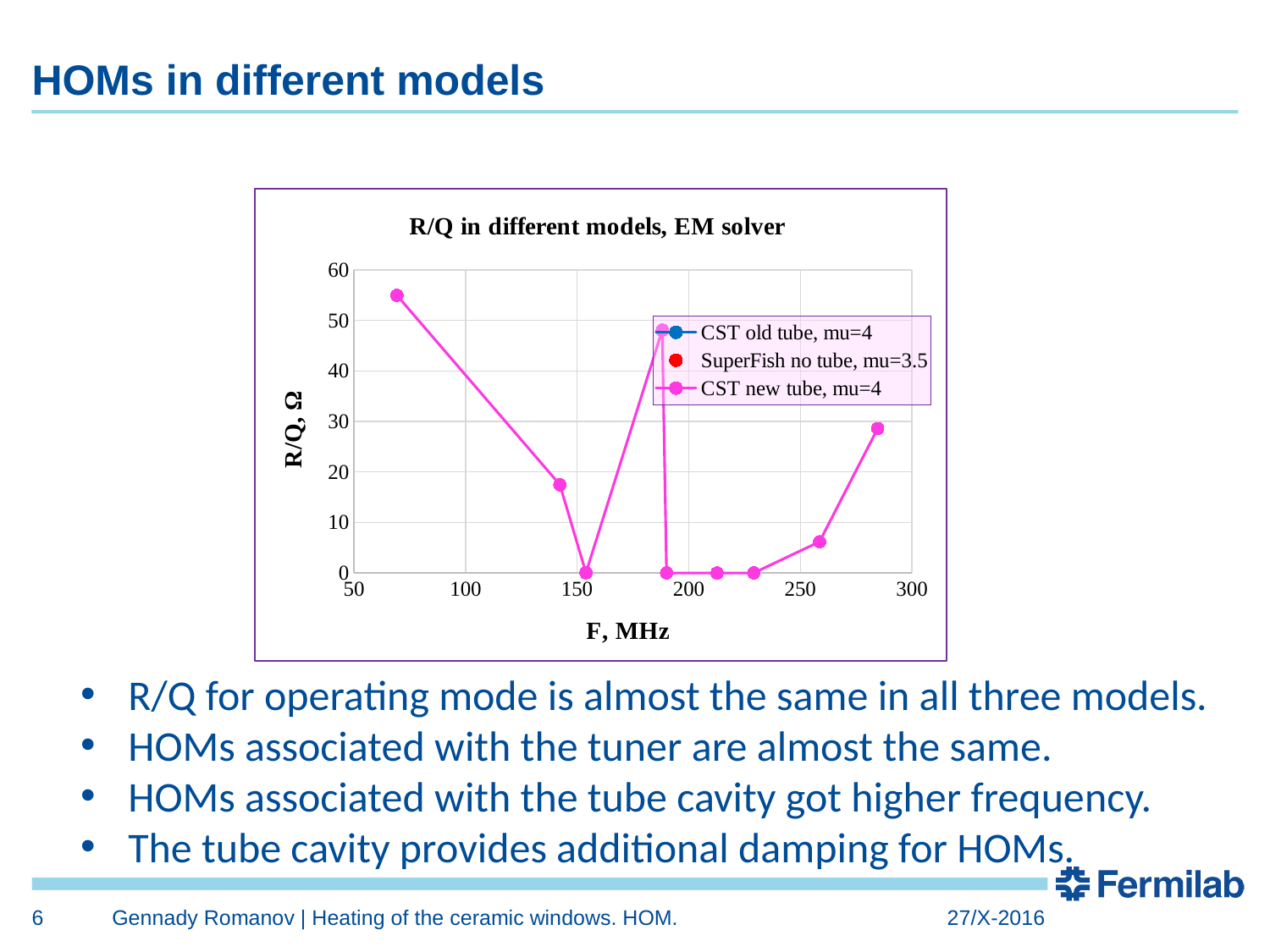
How many series does the legend list? 3 What is the title of the chart? R/Q in different models, EM solver Does the R/Q of the CST new tube, mu=4 series rise or fall between the point near 230 MHz and the point near 285 MHz? rise What is the maximum value shown on the y axis of the chart? 60 Is the R/Q value of the CST new tube, mu=4 series at its second point (near 140 MHz) greater or less than 20? less What is the label of the x axis? F, MHz Is the highest R/Q value of the CST new tube, mu=4 series greater or less than 50? greater What kind of chart is shown on the slide? line chart Is the R/Q value of the CST new tube, mu=4 series at the point near 260 MHz greater or less than 10? less Which is larger for the CST new tube, mu=4 series: the R/Q at the first point (near 70 MHz) or the R/Q at the peak near 190 MHz? the first point (near 70 MHz) Does the R/Q of the CST new tube, mu=4 series rise or fall between its first point (near 70 MHz) and the point near 155 MHz? fall